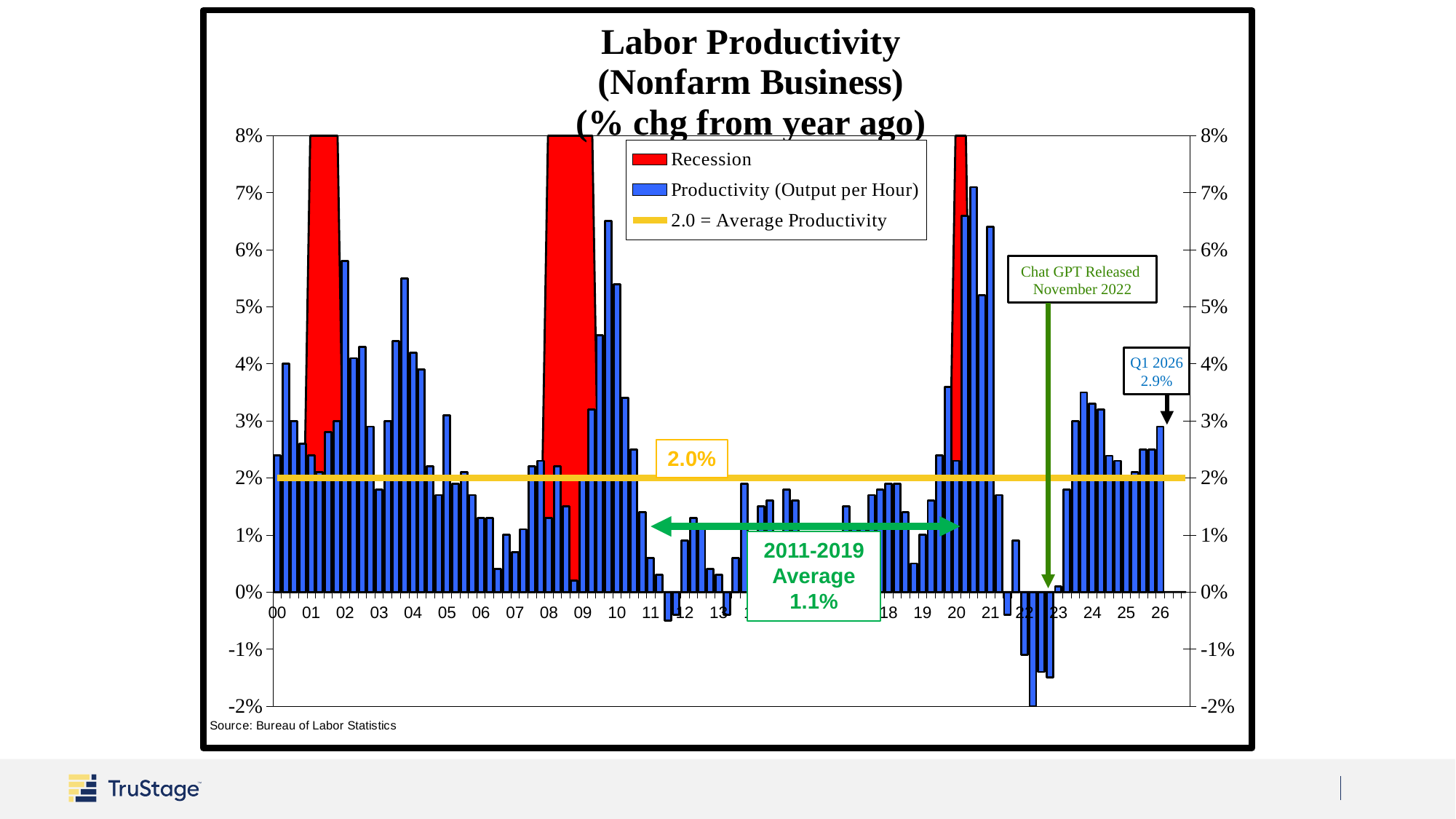
What kind of chart is shown on the slide? Bar chart Is the Q1 2026 productivity value greater or less than 2%? greater Which is larger: the Q1 2026 value or the 2011-2019 average? Q1 2026 By how many percentage points does the Q1 2026 value exceed the 2.0% average productivity line? 0.9 percentage points How many entries does the legend list? 3 According to the annotation, when was Chat GPT released? November 2022 What was the average productivity growth for 2011-2019 according to the annotation? 1.1% By how many percentage points does the Q1 2026 value exceed the 2011-2019 average? 1.8 percentage points What is the source cited for the chart data? Bureau of Labor Statistics Is the lowest productivity bar in 2022 greater or less than -1%? less What is the labor productivity value for Q1 2026? 2.9% What value does the yellow average productivity line represent? 2.0%